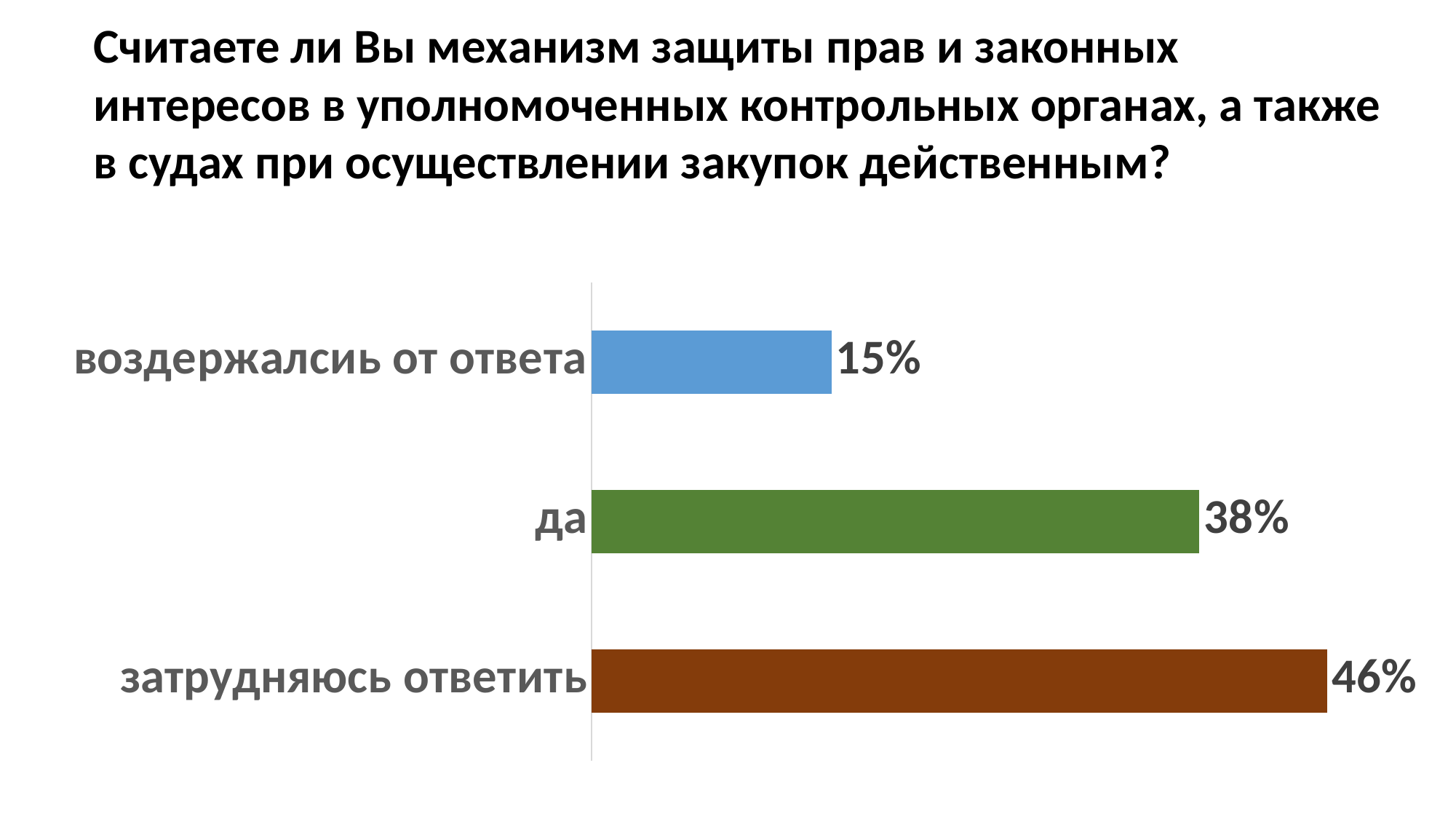
What is the value for "воздержалсиь от ответа"? 15% What colour is the bar for "затрудняюсь ответить"? brown Which category has the highest value? затрудняюсь ответить What is the difference between the values for "да" and "воздержалсиь от ответа"? 23% What kind of chart is shown on the slide? bar chart What colour is the bar for "да"? green What is the value for "затрудняюсь ответить"? 46% Which category has the lowest value? воздержалсиь от ответа What is the value for "да"? 38% How many categories are shown in the chart? 3 Which is larger, the value for "да" or the value for "воздержалсиь от ответа"? да What is the difference between the values for "затрудняюсь ответить" and "да"? 8%